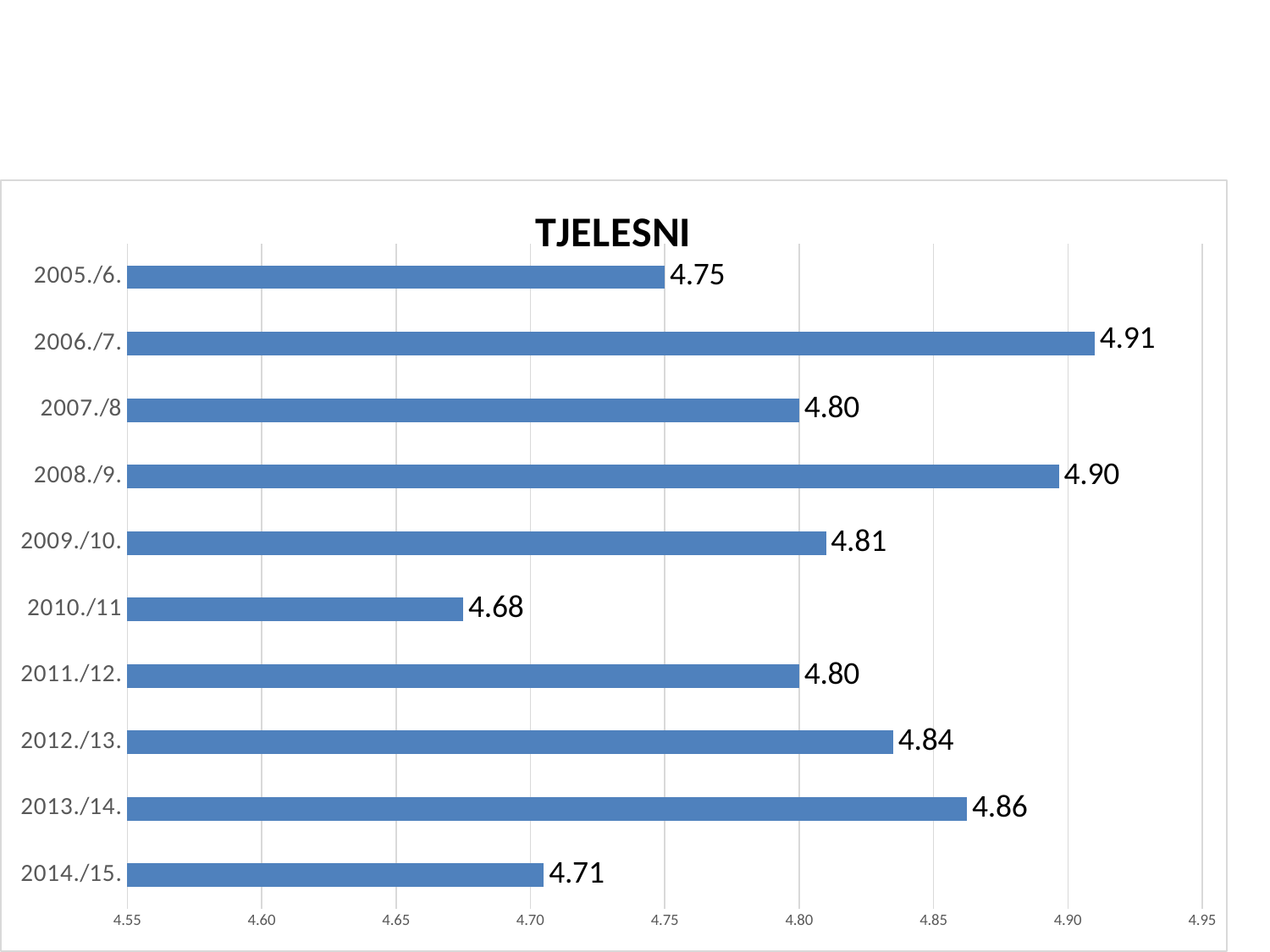
What is the value for 2006./7.? 4.91 Which is larger, the value for 2013./14. or the value for 2014./15.? 2013./14. How many categories are shown in the chart? 10 What is the title of the chart? TJELESNI Which category has the highest value? 2006./7. What is the value for 2012./13.? 4.84 What is the difference between the values for 2006./7. and 2010./11? 0.23 What kind of chart is shown? bar chart Which category has the lowest value? 2010./11 What is the value for 2010./11? 4.68 Is the value for 2009./10. greater or less than 4.75? greater What is the value for 2014./15.? 4.71